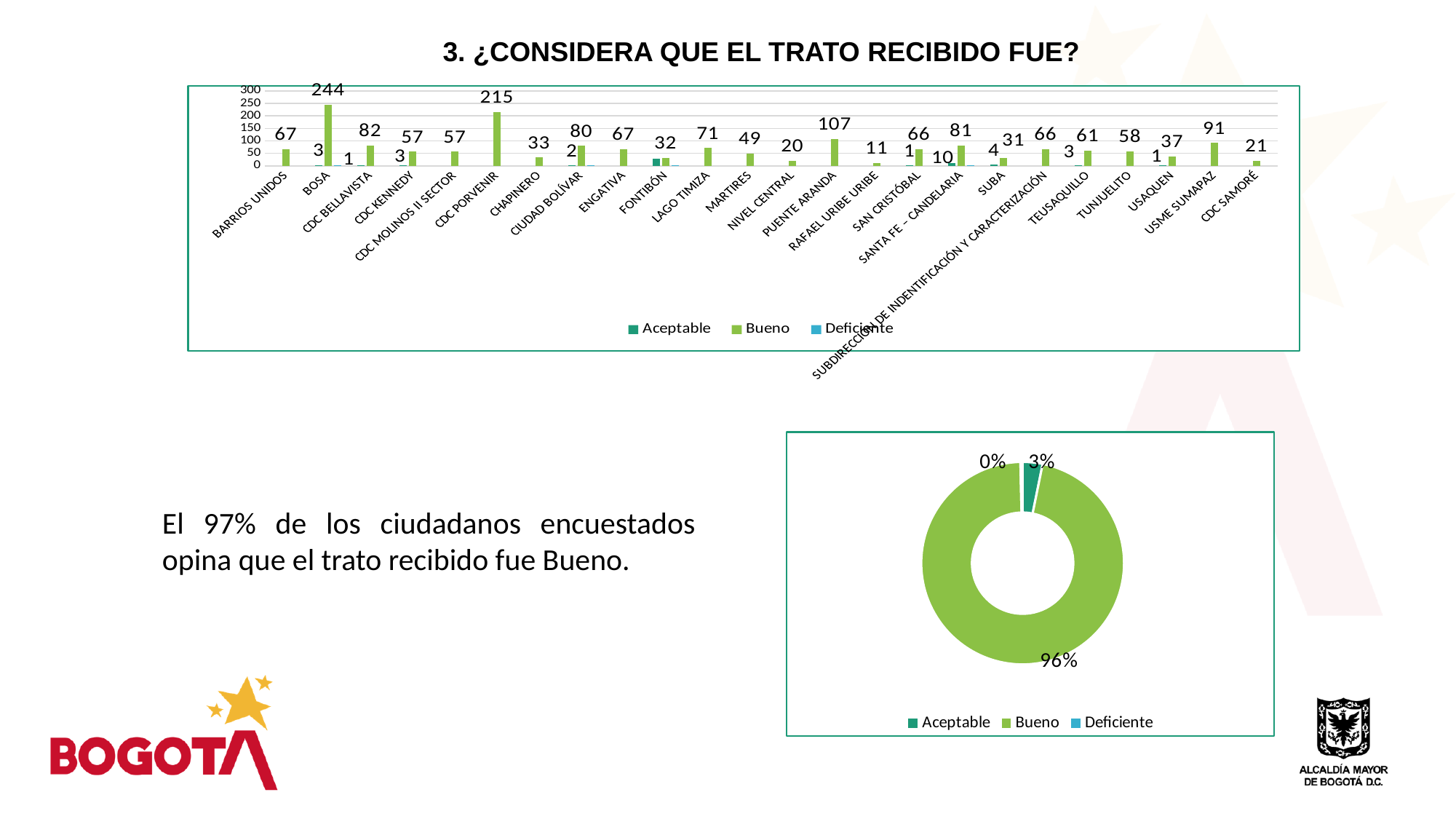
In the bar chart, what is the difference between the Bueno values for BOSA and CDC PORVENIR? 29 In the bar chart, which has the larger Bueno value, PUENTE ARANDA or USME SUMAPAZ? PUENTE ARANDA In the doughnut chart at the bottom right, what share does Aceptable have? 3% In the bar chart, which category has the highest Bueno value? BOSA In the bar chart, what is the Bueno value for BOSA? 244 In the doughnut chart at the bottom right, what share does Bueno have? 96% In the bar chart, what is the Bueno value for PUENTE ARANDA? 107 How many series does the legend of the bar chart list? 3 What kind of chart is the top chart on the slide? Bar chart How many categories are shown on the x axis of the bar chart? 24 In the bar chart, what is the Aceptable value for SANTA FE – CANDELARIA? 10 In the bar chart, is the Bueno value for CHAPINERO greater or less than 50? less